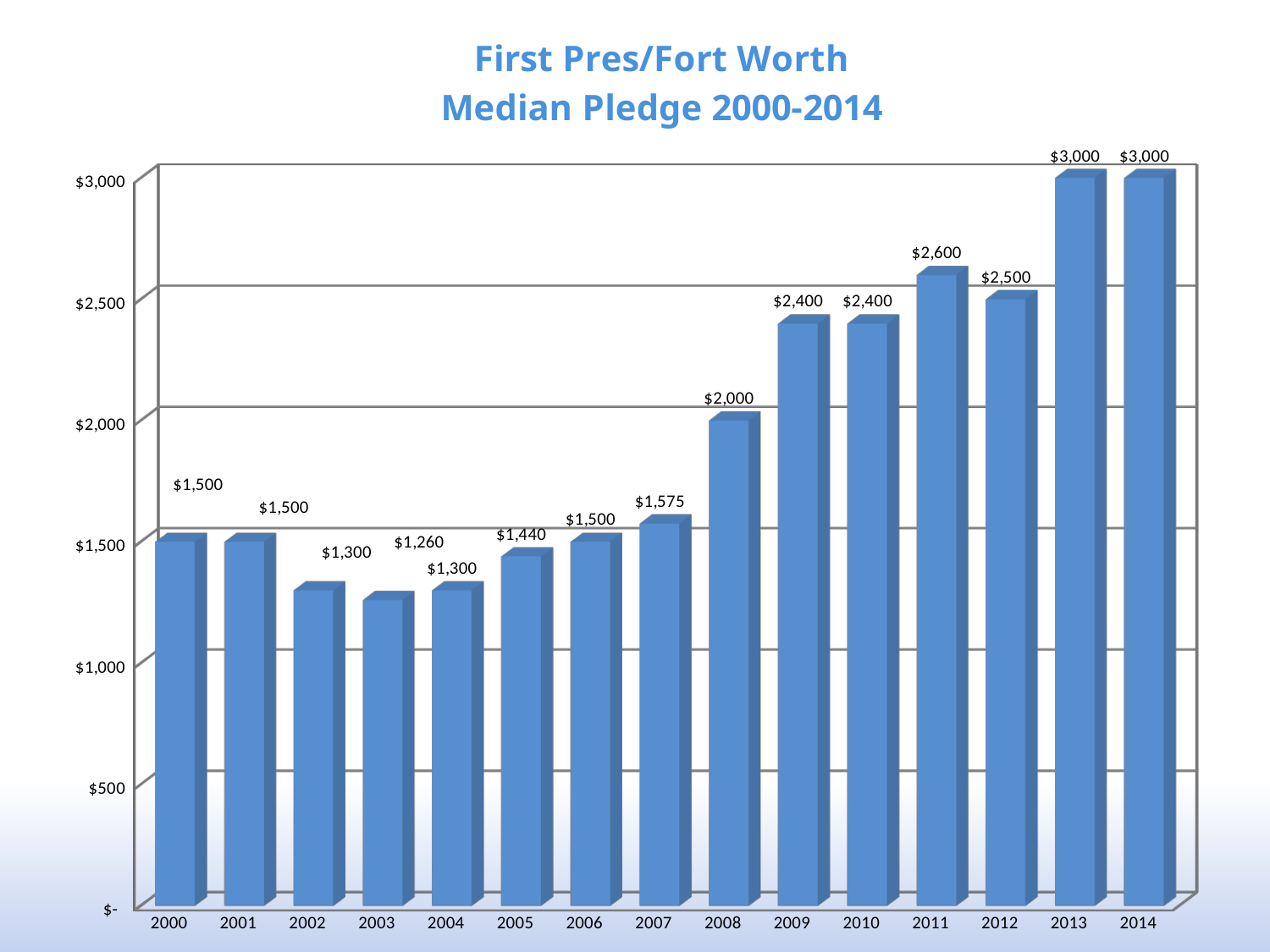
What is the title of the chart? First Pres/Fort Worth Median Pledge 2000-2014 What is the highest median pledge value shown on the chart? $3,000 What is the median pledge for 2005? $1,440 What is the difference between the median pledge in 2009 and in 2008? $400 What is the median pledge for 2011? $2,600 Is the median pledge for 2010 greater or less than $2,000? greater What kind of chart is shown on the slide? Bar chart How many years are shown on the x axis? 15 Which year has a larger median pledge, 2007 or 2004? 2007 What is the median pledge for 2008? $2,000 Which year has the lowest median pledge? 2003 What is the difference between the median pledge in 2012 and in 2011? $100